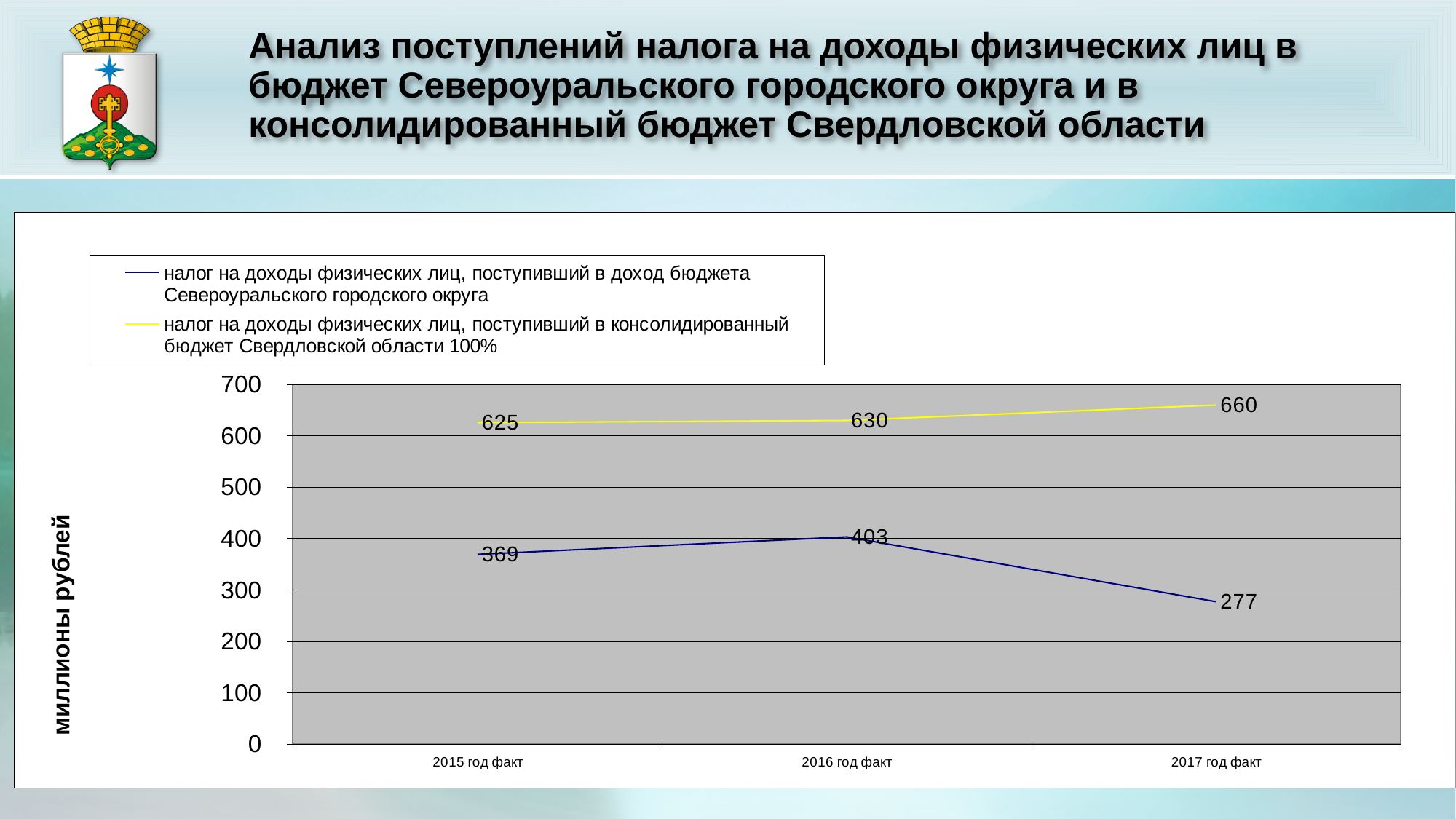
What is the value for 2017 год факт for the tax received by the consolidated budget of Свердловская область? 660 What is the value for 2016 год факт for the tax received by the budget of Североуральский городской округ? 403 How many series does the legend list? 2 What is the label of the vertical axis? миллионы рублей In which year is the value for the tax received by the budget of Североуральский городской округ the lowest? 2017 год факт Does the value for the tax received by the budget of Североуральский городской округ rise or fall from 2016 год факт to 2017 год факт? fall What type of chart is shown on the slide? line chart What is the difference between the two series' values for 2017 год факт? 383 How many points are plotted along the x axis for each series? 3 What is the value for 2015 год факт for the tax received by the budget of Североуральский городской округ? 369 Which is larger for 2016 год факт: the value for the consolidated budget of Свердловская область or the value for the budget of Североуральский городской округ? consolidated budget of Свердловская область In which year is the value for the tax received by the consolidated budget of Свердловская область the highest? 2017 год факт